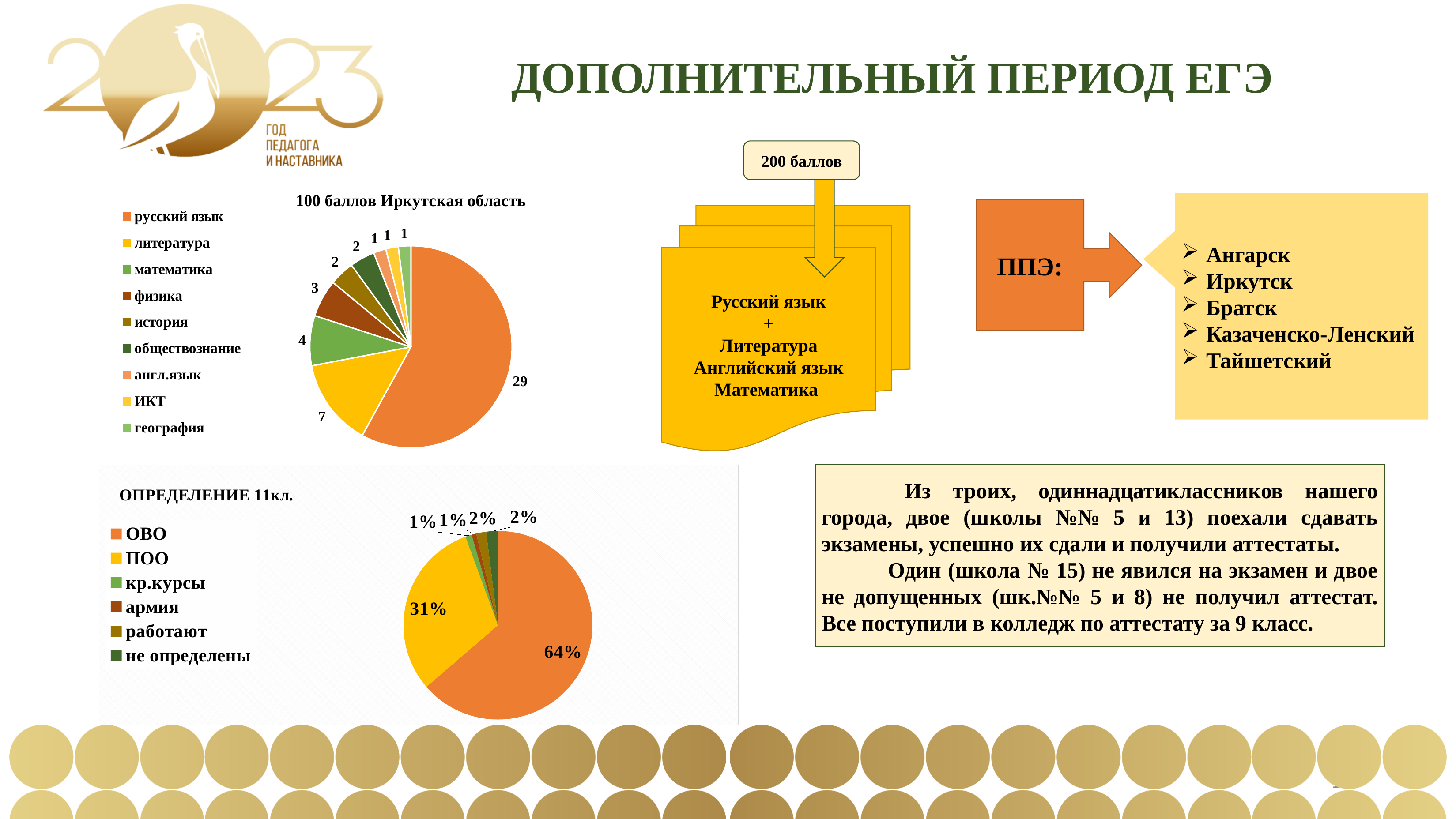
In the chart titled "100 баллов Иркутская область", which is larger: the value for физика or the value for математика? математика In the chart titled "100 баллов Иркутская область", how many categories does the legend list? 9 In the chart titled "100 баллов Иркутская область", what is the value for литература? 7 In the chart titled "ОПРЕДЕЛЕНИЕ 11кл.", what is the share for ПОО? 31% In the chart titled "ОПРЕДЕЛЕНИЕ 11кл.", how many categories does the legend list? 6 In the chart titled "100 баллов Иркутская область", what is the difference between the values for русский язык and литература? 22 In the chart titled "100 баллов Иркутская область", which category has the highest value? русский язык In the chart titled "100 баллов Иркутская область", what is the value for математика? 4 What type of chart is the chart titled "ОПРЕДЕЛЕНИЕ 11кл."? pie chart In the chart titled "100 баллов Иркутская область", what is the value for русский язык? 29 In the chart titled "ОПРЕДЕЛЕНИЕ 11кл.", what is the share for ОВО? 64% In the chart titled "ОПРЕДЕЛЕНИЕ 11кл.", what is the difference between the shares for ОВО and ПОО? 33%